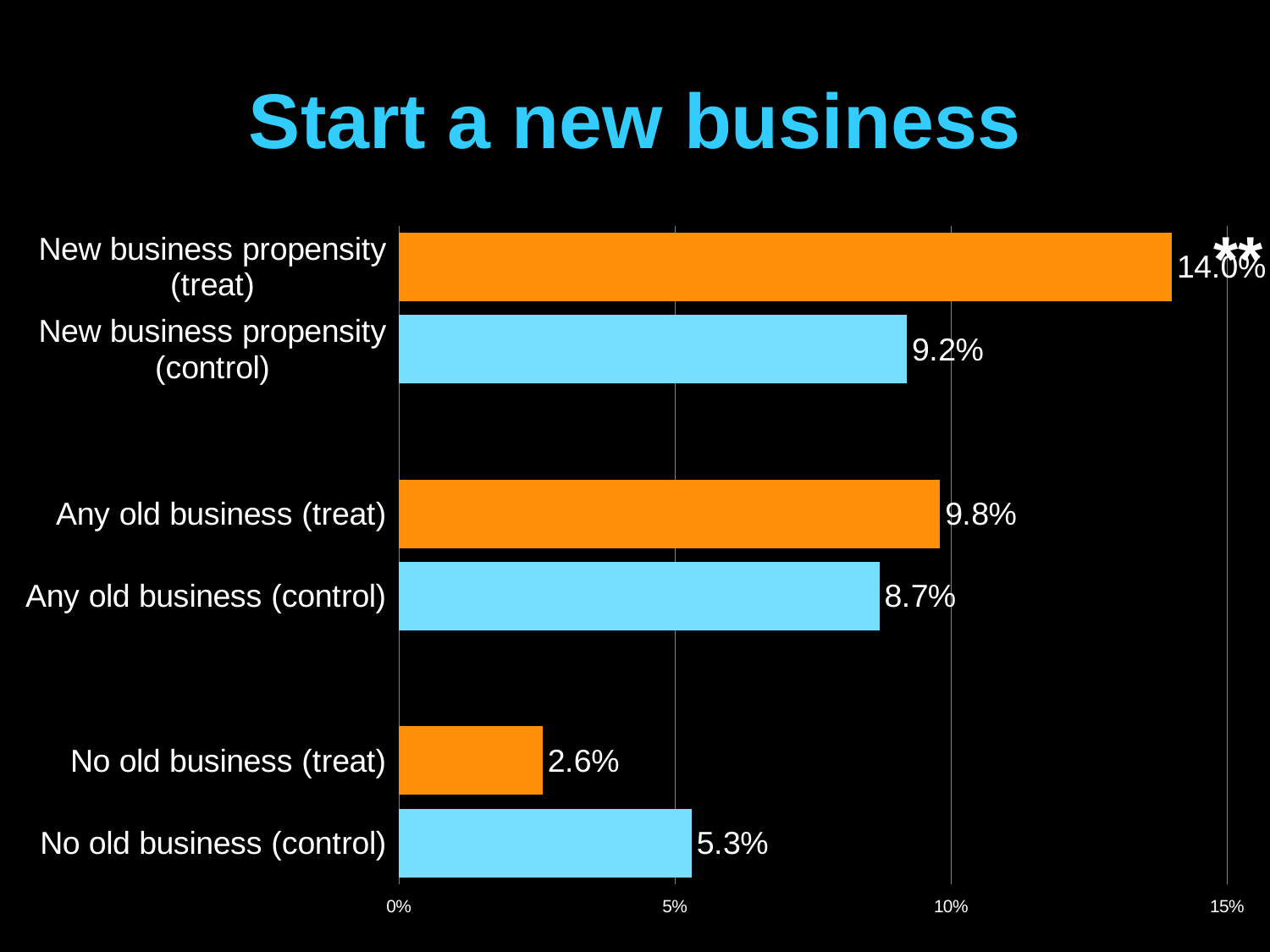
What kind of chart is shown on the slide? Bar chart What is the value for No old business (treat)? 2.6% Is the value for New business propensity (treat) greater or less than 10%? greater What is the value for No old business (control)? 5.3% Which is larger, No old business (treat) or No old business (control)? No old business (control) What is the difference between Any old business (treat) and Any old business (control)? 1.1% What is the value for Any old business (control)? 8.7% What is the value for New business propensity (control)? 9.2% How many bars are shown in the chart? 6 Which category has the lowest value? No old business (treat) What is the value for Any old business (treat)? 9.8% Which category has the highest value? New business propensity (treat)